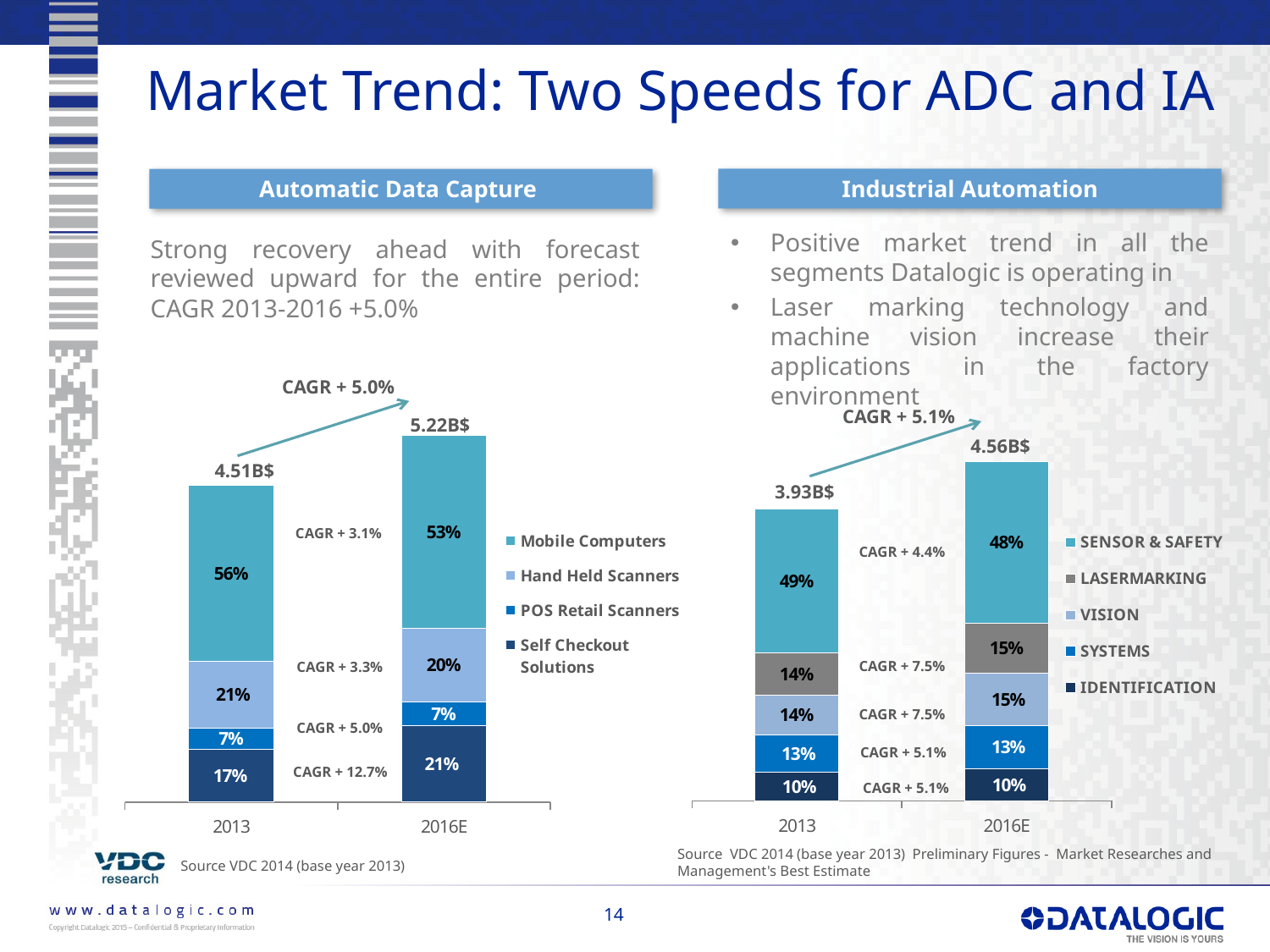
In the Automatic Data Capture chart, which segment has the largest share in 2013? Mobile Computers In the Industrial Automation chart, is the Sensor & Safety share in 2013 larger or smaller than the Systems share in 2013? larger In the Automatic Data Capture chart, by how many percentage points does the Self Checkout Solutions share change from 2013 to 2016E? 4 percentage points In the Automatic Data Capture chart, what share do Self Checkout Solutions hold in 2016E? 21% What type of chart is used for the Industrial Automation data? Stacked bar chart In the Industrial Automation chart, what share does Sensor & Safety hold in 2016E? 48% In the Industrial Automation chart, what total market value is labelled above the 2013 bar? 3.93B$ In the Automatic Data Capture chart, what share do Mobile Computers hold in 2013? 56% How many series does the legend of the Automatic Data Capture chart list? 4 How many series does the legend of the Industrial Automation chart list? 5 In the Industrial Automation chart, which segment has the smallest share in 2013? Identification In the Automatic Data Capture chart, what total market value is labelled above the 2016E bar? 5.22B$